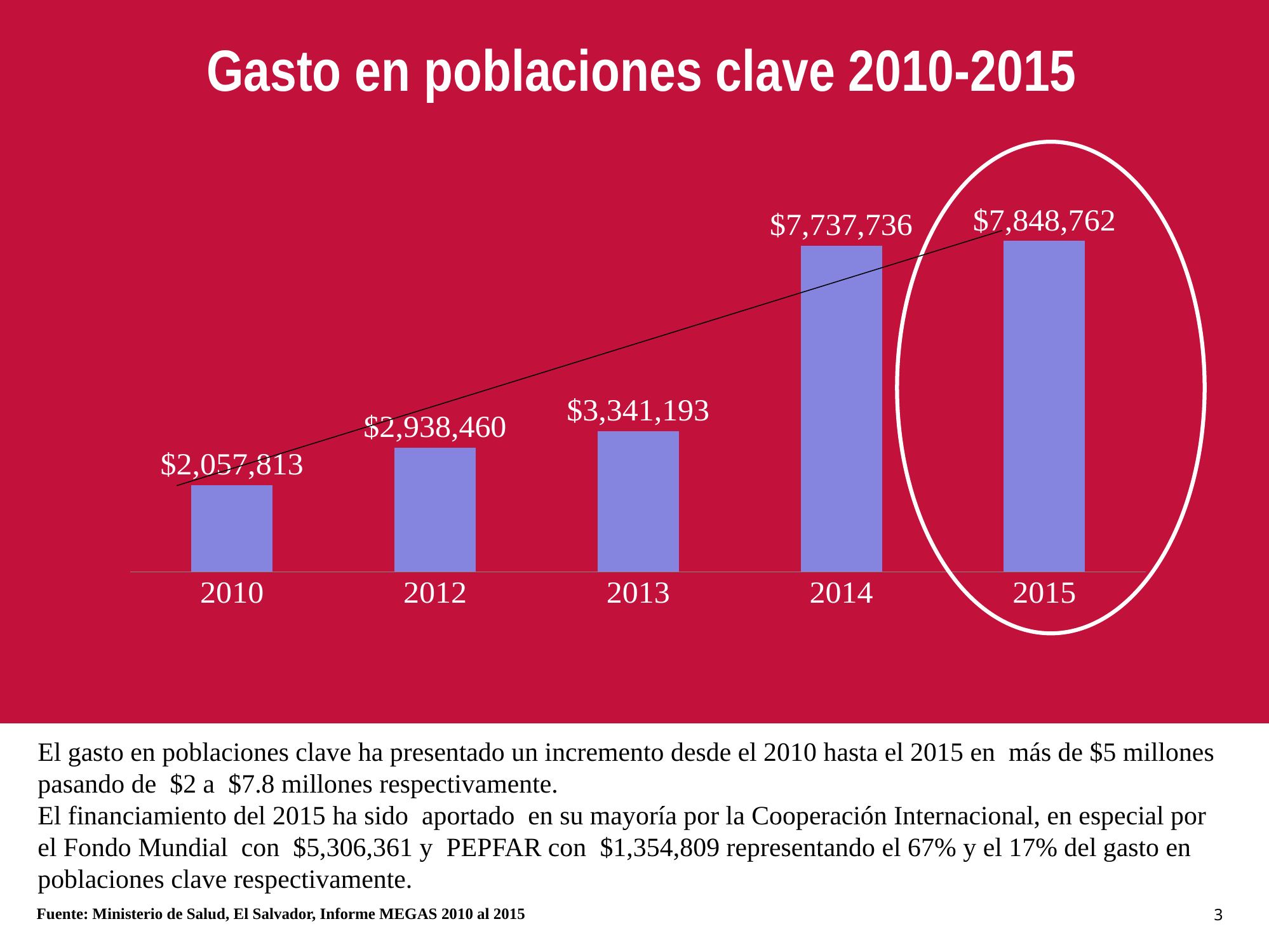
What was the spending on key populations in 2010? $2,057,813 Do the values generally rise or fall from 2010 to 2015? rise What was the spending on key populations in 2012? $2,938,460 What is the title of the chart? Gasto en poblaciones clave 2010-2015 What type of chart is shown on the slide? bar chart What was the spending on key populations in 2014? $7,737,736 What was the spending on key populations in 2013? $3,341,193 How many years (bars) are shown in the chart? 5 Which year has the highest spending in the chart? 2015 Which year has the lowest spending in the chart? 2010 What is the difference between the spending in 2015 and in 2010? $5,790,949 What was the spending on key populations in 2015? $7,848,762